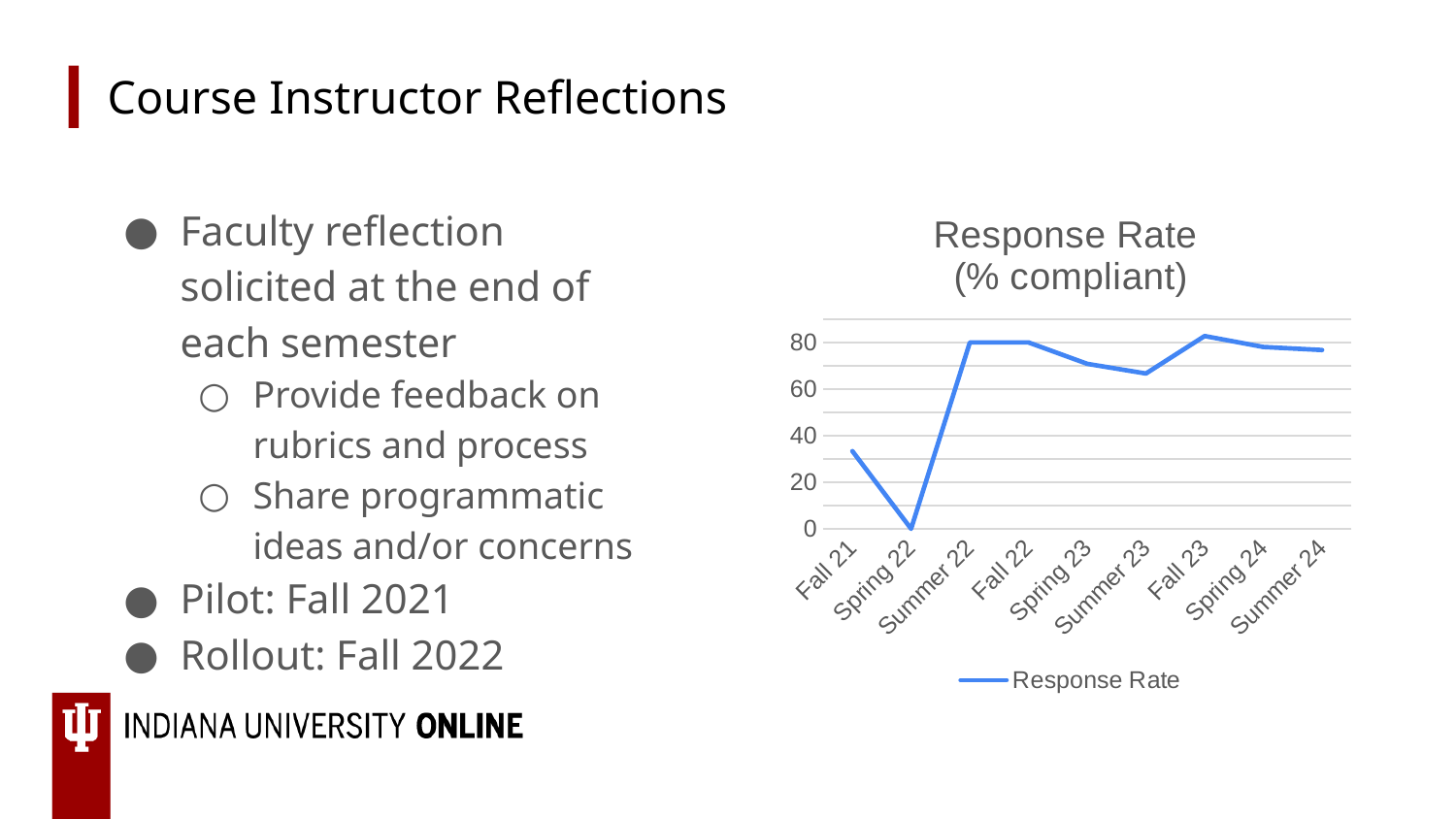
How many semesters are plotted along the x axis of the chart? 9 What is the title of the chart? Response Rate (% compliant) Is the response rate for Fall 23 greater or less than 80? greater What kind of chart is shown on the slide? line chart Which has a higher response rate, Fall 21 or Summer 22? Summer 22 Which semester has the highest response rate? Fall 23 Is the response rate for Fall 21 greater or less than 40? less How many series does the chart's legend list? 1 Does the response rate rise or fall from Spring 22 to Summer 22? rise What is the response rate for Spring 22? 0 Is the response rate for Summer 23 greater or less than 60? greater Which semester has the lowest response rate? Spring 22